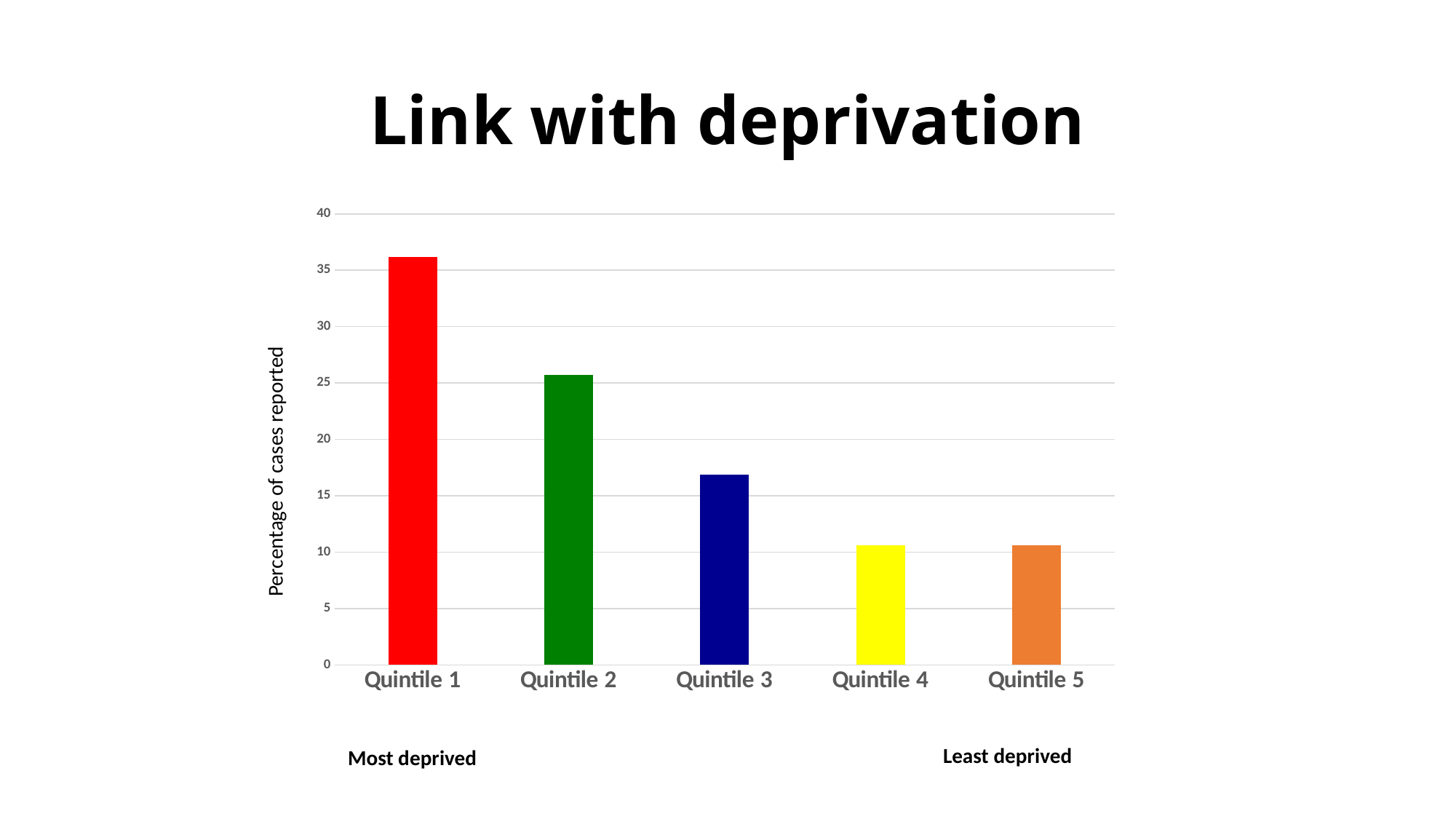
Is the value for Quintile 4 greater or less than 15? less Is the value for Quintile 3 greater or less than 20? less What is the label on the vertical axis of the chart? Percentage of cases reported Is the value for Quintile 1 greater or less than 30? greater Which is larger, the value for Quintile 2 or the value for Quintile 3? Quintile 2 How many quintile categories are plotted on the chart? 5 What kind of chart is shown on the slide? bar chart What is the title of the slide? Link with deprivation Which quintile has the highest percentage of cases reported? Quintile 1 Do the values rise or fall moving from Quintile 1 to Quintile 5 along the x axis? fall